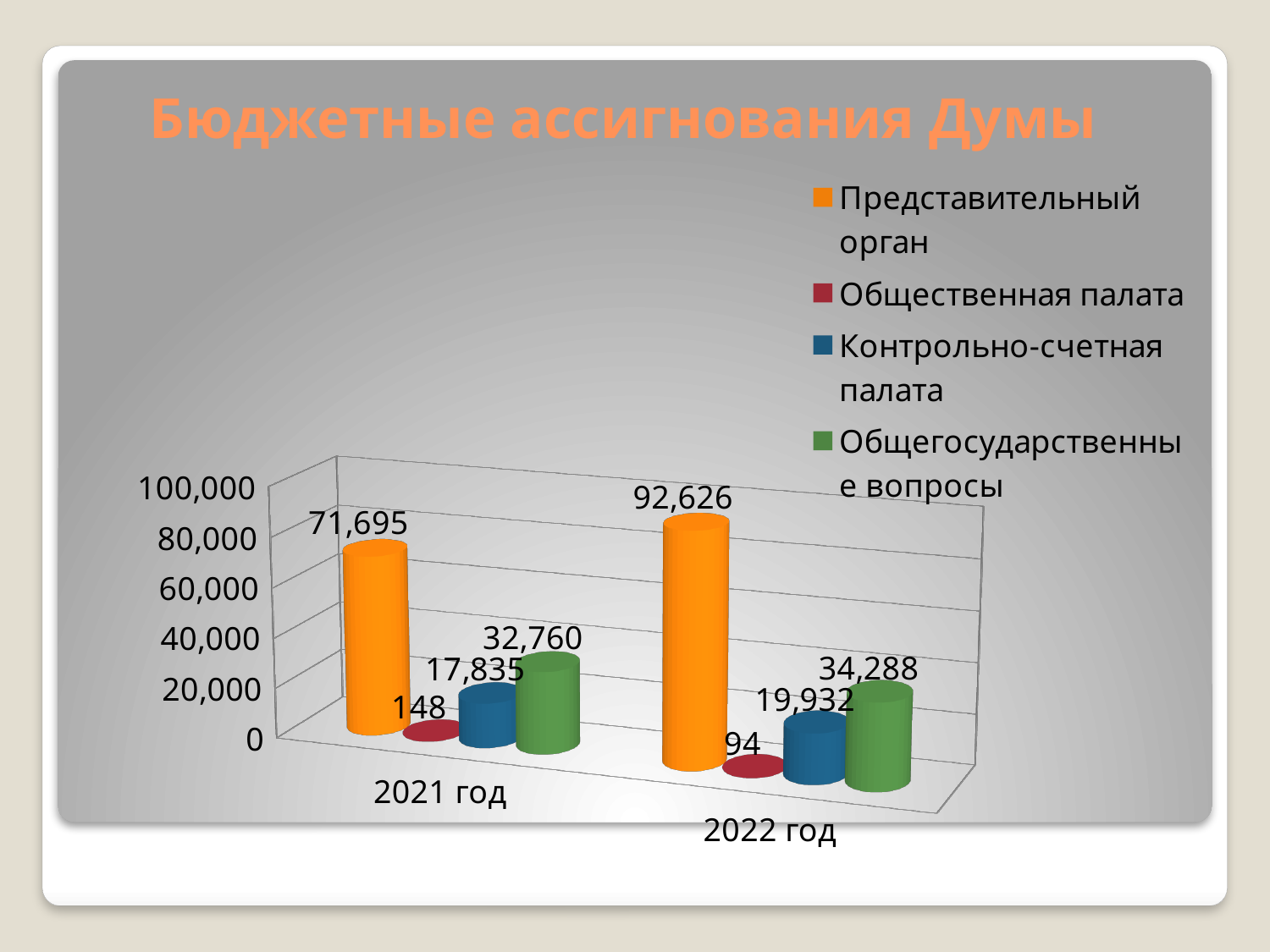
What kind of chart is shown on the slide? Bar chart Which is larger: Общегосударственные вопросы in 2021 год or in 2022 год? 2022 год What is the value for Контрольно-счетная палата in 2022 год? 19,932 Which series has the lowest value in 2021 год? Общественная палата Which series has the highest value in 2022 год? Представительный орган What is the value for Общественная палата in 2021 год? 148 What is the title of the chart? Бюджетные ассигнования Думы What is the value for Представительный орган in 2021 год? 71,695 What is the value for Общегосударственные вопросы in 2021 год? 32,760 What is the value for Представительный орган in 2022 год? 92,626 What is the difference between the Представительный орган values for 2022 год and 2021 год? 20,931 How many series does the legend list? 4